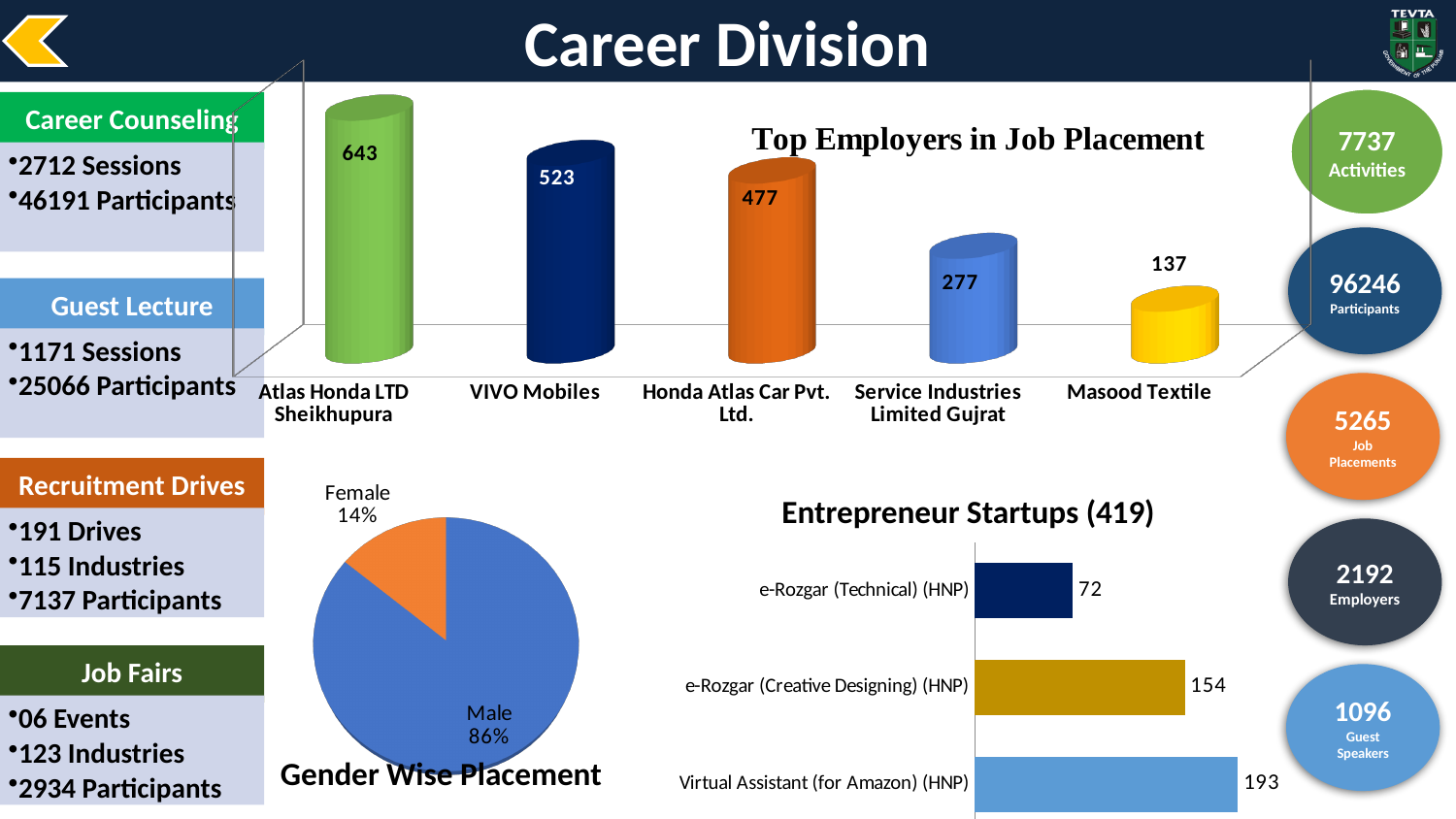
What kind of chart is the Gender Wise Placement chart? pie chart In the Top Employers in Job Placement chart, what is the value for Service Industries Limited Gujrat? 277 In the Top Employers in Job Placement chart, how many employers are shown? 5 In the Top Employers in Job Placement chart, what is the value for Atlas Honda LTD Sheikhupura? 643 In the Entrepreneur Startups (419) chart, which is larger: e-Rozgar (Technical) (HNP) or e-Rozgar (Creative Designing) (HNP)? e-Rozgar (Creative Designing) (HNP) What kind of chart is the Entrepreneur Startups (419) chart? bar chart In the Entrepreneur Startups (419) chart, which category has the highest value? Virtual Assistant (for Amazon) (HNP) In the Gender Wise Placement chart, what share of the pie is Female? 14% In the Top Employers in Job Placement chart, what is the difference between VIVO Mobiles and Honda Atlas Car Pvt. Ltd.? 46 In the Top Employers in Job Placement chart, which employer has the lowest value? Masood Textile In the Entrepreneur Startups (419) chart, what is the value for e-Rozgar (Creative Designing) (HNP)? 154 In the Top Employers in Job Placement chart, do the values rise or fall from left to right? fall